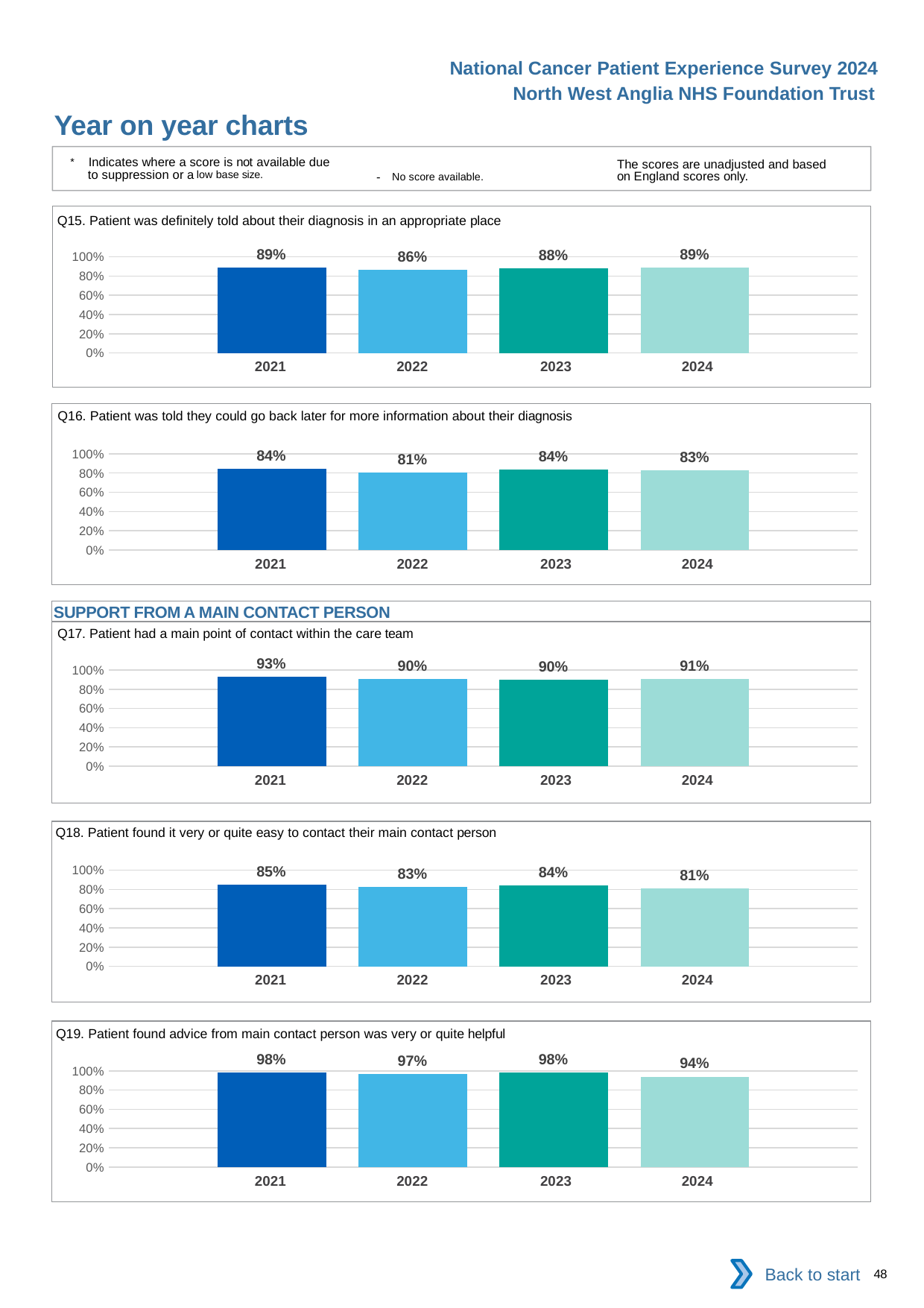
In the Q17 chart, what is the difference between the 2021 value and the 2024 value? 2 percentage points In the Q18 chart, which is larger, the value for 2021 or the value for 2023? 2021 In the Q18 chart, do the values rise or fall from 2023 to 2024? Fall In the Q17 chart (patient had a main point of contact within the care team), which year has the highest value? 2021 How many years (categories) are shown in the Q15 chart? 4 What type of chart is used for Q16? Bar chart In the Q18 chart (patient found it very or quite easy to contact their main contact person), what is the value for 2024? 81% In the Q15 chart (patient was definitely told about their diagnosis in an appropriate place), what is the value for 2022? 86% In the Q19 chart, what is the difference between the 2023 value and the 2024 value? 4 percentage points In the Q16 chart (patient was told they could go back later for more information), which year has the lowest value? 2022 In the Q19 chart (patient found advice from main contact person was very or quite helpful), what is the value for 2024? 94% What is the section heading shown above the Q17 chart? SUPPORT FROM A MAIN CONTACT PERSON